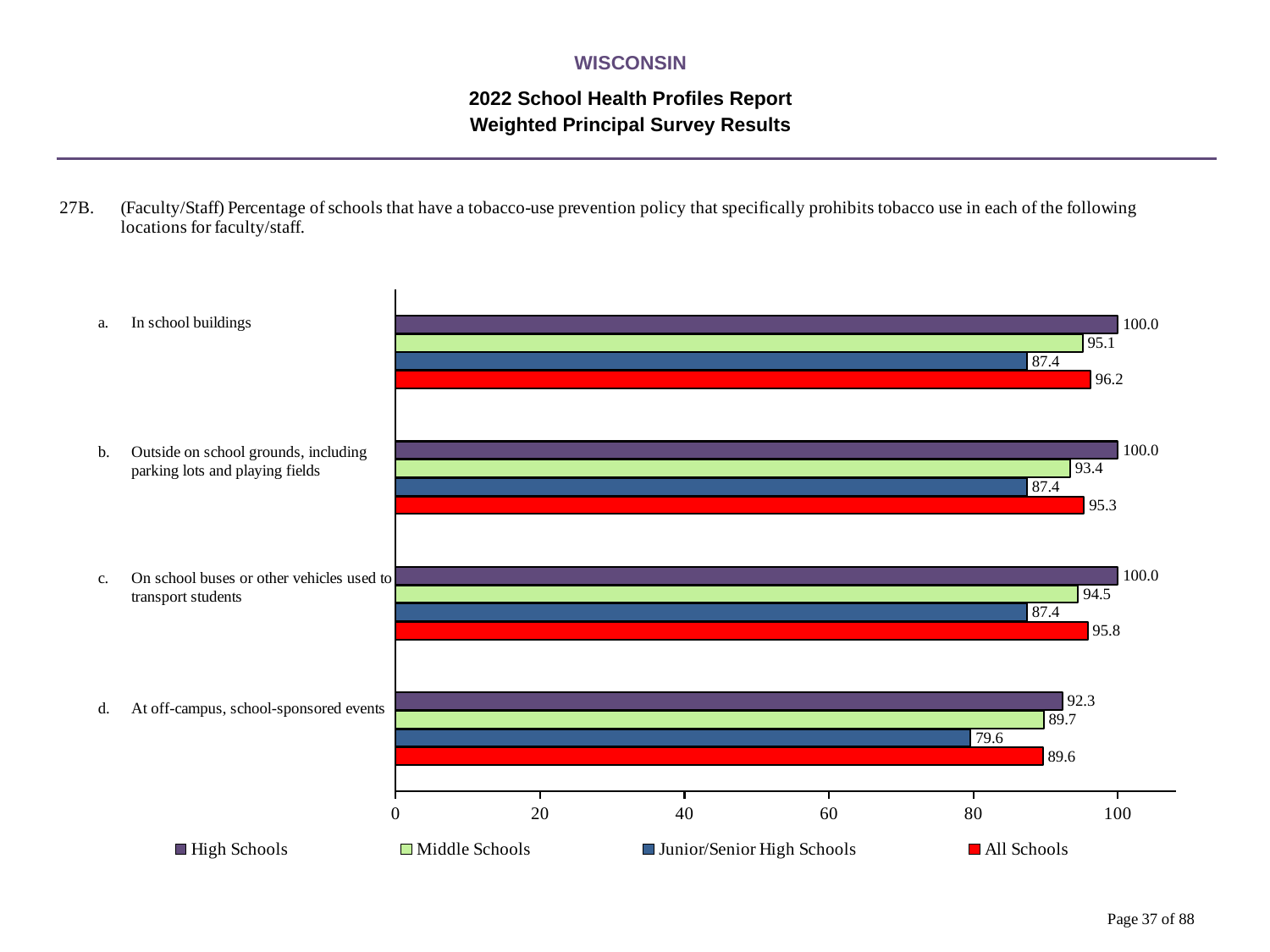
What is the value for Middle Schools for 'On school buses or other vehicles used to transport students'? 94.5 Which series has the highest value for 'At off-campus, school-sponsored events'? High Schools What is the value for High Schools for 'In school buildings'? 100.0 What is the difference between the High Schools and Junior/Senior High Schools values for 'In school buildings'? 12.6 How many locations (categories) are shown in the chart? 4 What is the value for Junior/Senior High Schools for 'At off-campus, school-sponsored events'? 79.6 What kind of chart is shown on the slide? Bar chart How many series does the legend list? 4 Which is larger for 'At off-campus, school-sponsored events': Middle Schools or All Schools? Middle Schools Which colour represents All Schools in the chart? Red Which location has the lowest value for All Schools? At off-campus, school-sponsored events What is the value for All Schools for 'Outside on school grounds, including parking lots and playing fields'? 95.3